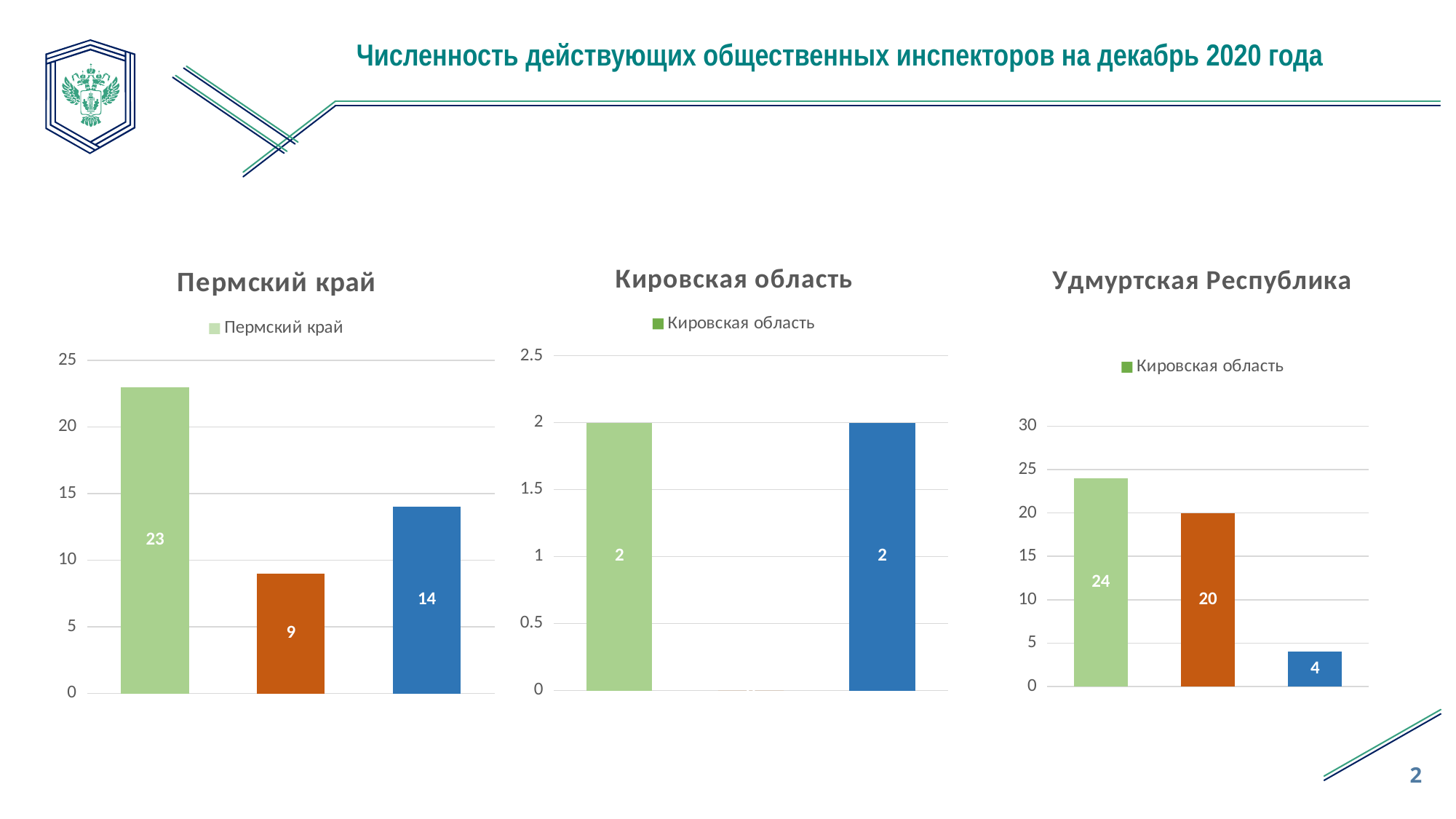
In the 'Удмуртская Республика' chart, what is the value of the orange (second) bar? 20 What type of chart is the 'Пермский край' chart? Bar chart In the 'Пермский край' chart, what is the value of the blue (third) bar? 14 In the 'Пермский край' chart, what is the value of the orange (second) bar? 9 In the 'Пермский край' chart, what is the value of the green (first) bar? 23 In the 'Пермский край' chart, what is the difference between the green bar and the orange bar? 14 In the 'Пермский край' chart, which bar is the highest? The green (first) bar, 23 In the 'Кировская область' chart, what is the value of the blue (right) bar? 2 In the 'Удмуртская Республика' chart, is the green bar greater or less than 20? greater In the 'Удмуртская Республика' chart, which bar is the lowest? The blue (third) bar, 4 In the 'Удмуртская Республика' chart, what is the difference between the green bar and the blue bar? 20 How many entries does the legend of the 'Удмуртская Республика' chart list? 1